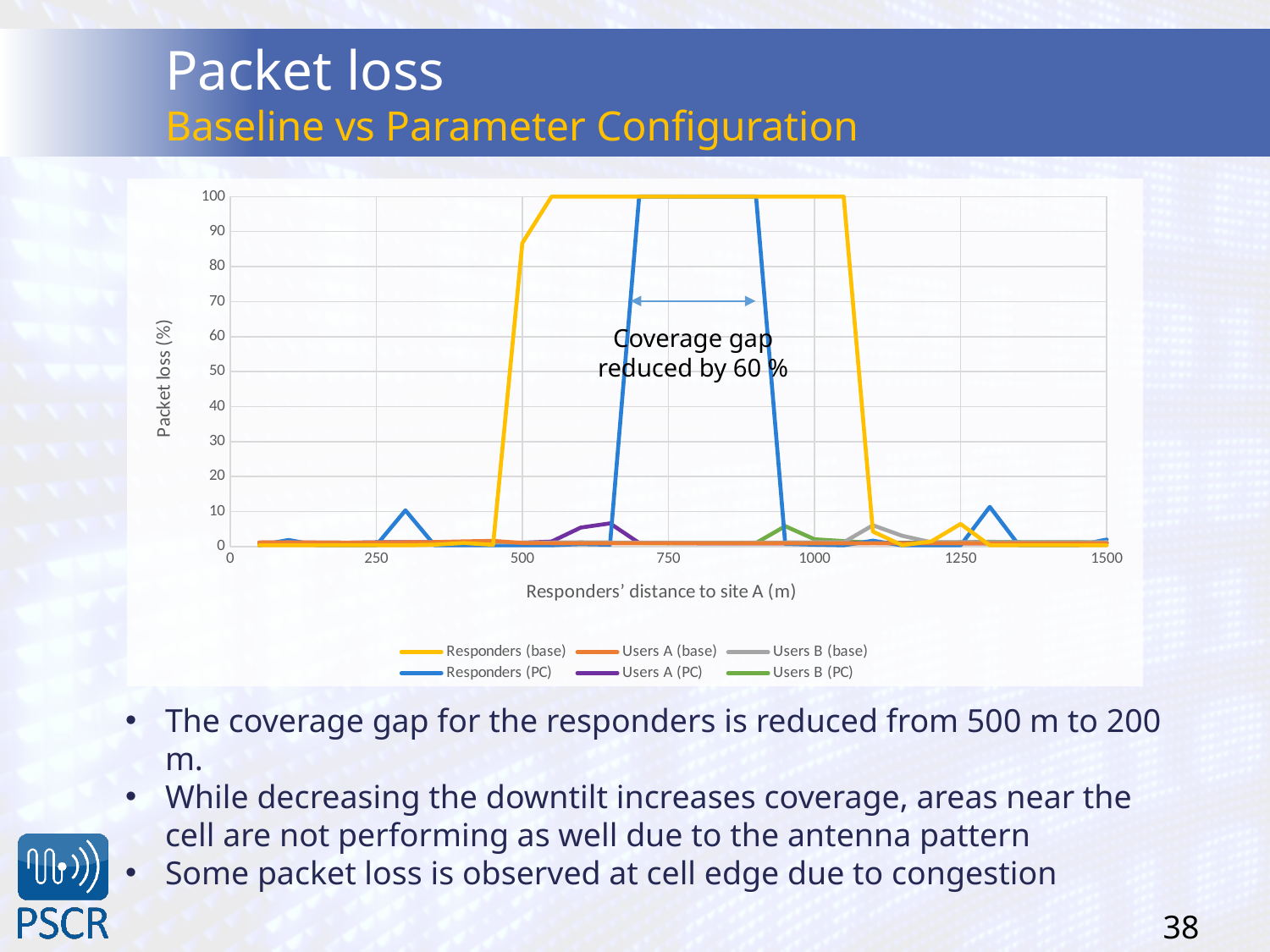
Is the packet loss for Responders (PC) at 1000 m greater or less than 10? less At 1000 m, which has the higher packet loss: Responders (base) or Responders (PC)? Responders (base) Is the packet loss for Responders (PC) at 500 m greater or less than 10? less At 500 m, which has the higher packet loss: Responders (base) or Responders (PC)? Responders (base) Is the packet loss for Responders (base) at 500 m greater or less than 80? greater What is the packet loss for Responders (base) at 750 m? 100 What does the annotation inside the chart say? Coverage gap reduced by 60 % What kind of chart is shown on the slide? line chart What is the x-axis title of the chart? Responders' distance to site A (m) How many series does the legend list? 6 What is the packet loss for Responders (PC) at 750 m? 100